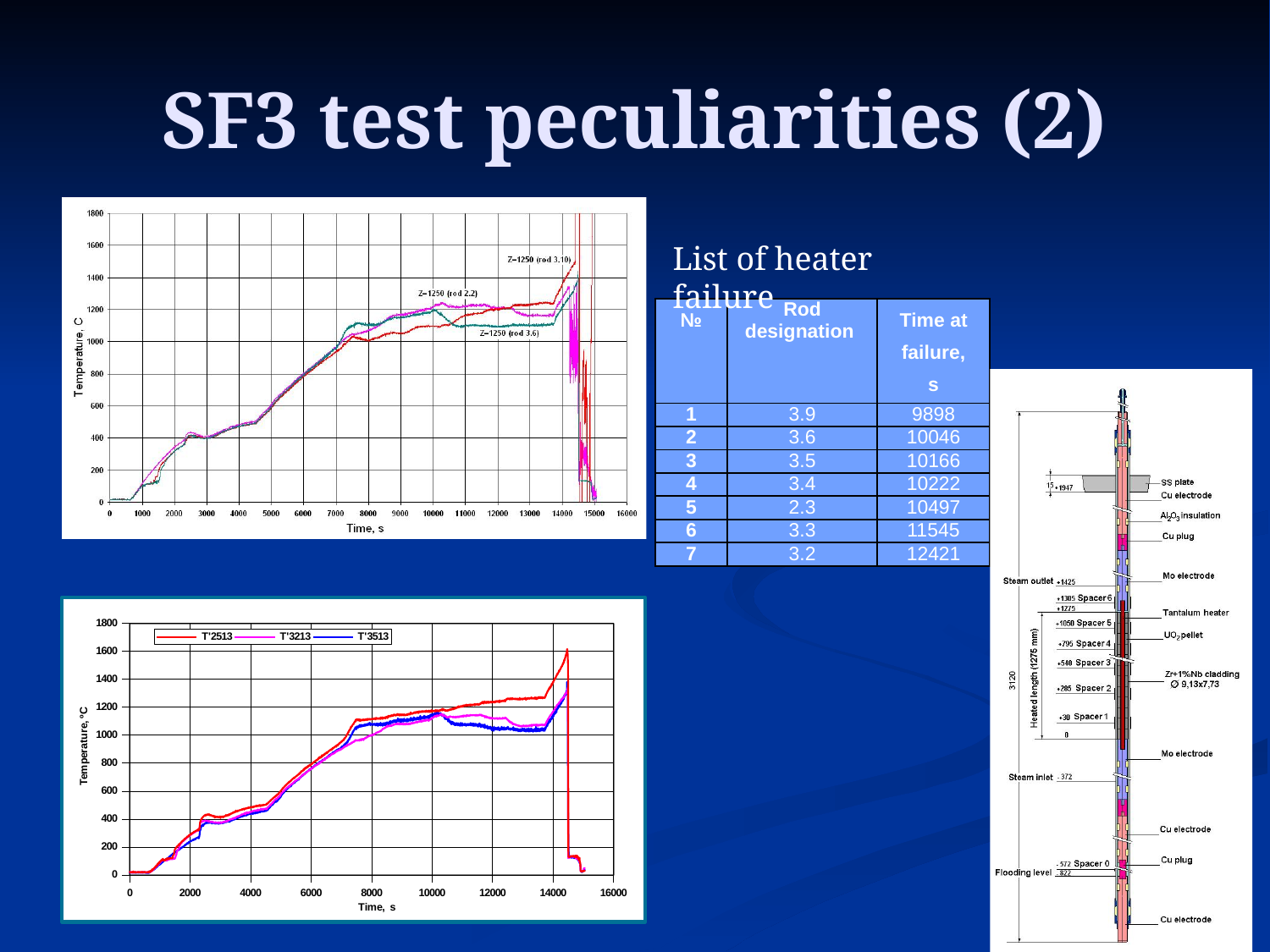
In the bottom-left chart, which series reaches the highest peak temperature? T'2513 What kind of chart is the bottom-left chart on the slide? line chart What is the x-axis label of the bottom-left chart? Time, s In the top-left chart, is the value for Z=1250 (rod 3.6) at 12000 s greater or less than 1200? less How many labelled curves are plotted on the top-left chart? 3 What are the legend entries of the bottom-left chart? T'2513, T'3213, T'3513 In the bottom-left chart, do the temperatures generally rise or fall between 0 and 14000 s? rise What kind of chart is the top-left chart on the slide? line chart In the top-left chart, which rod curve reaches the highest peak temperature? Z=1250 (rod 3.10) In the bottom-left chart, is the value for T'2513 at 4000 s greater or less than 600? less In the bottom-left chart, is the value for T'2513 at 12000 s greater or less than 1000? greater How many series does the legend of the bottom-left chart list? 3